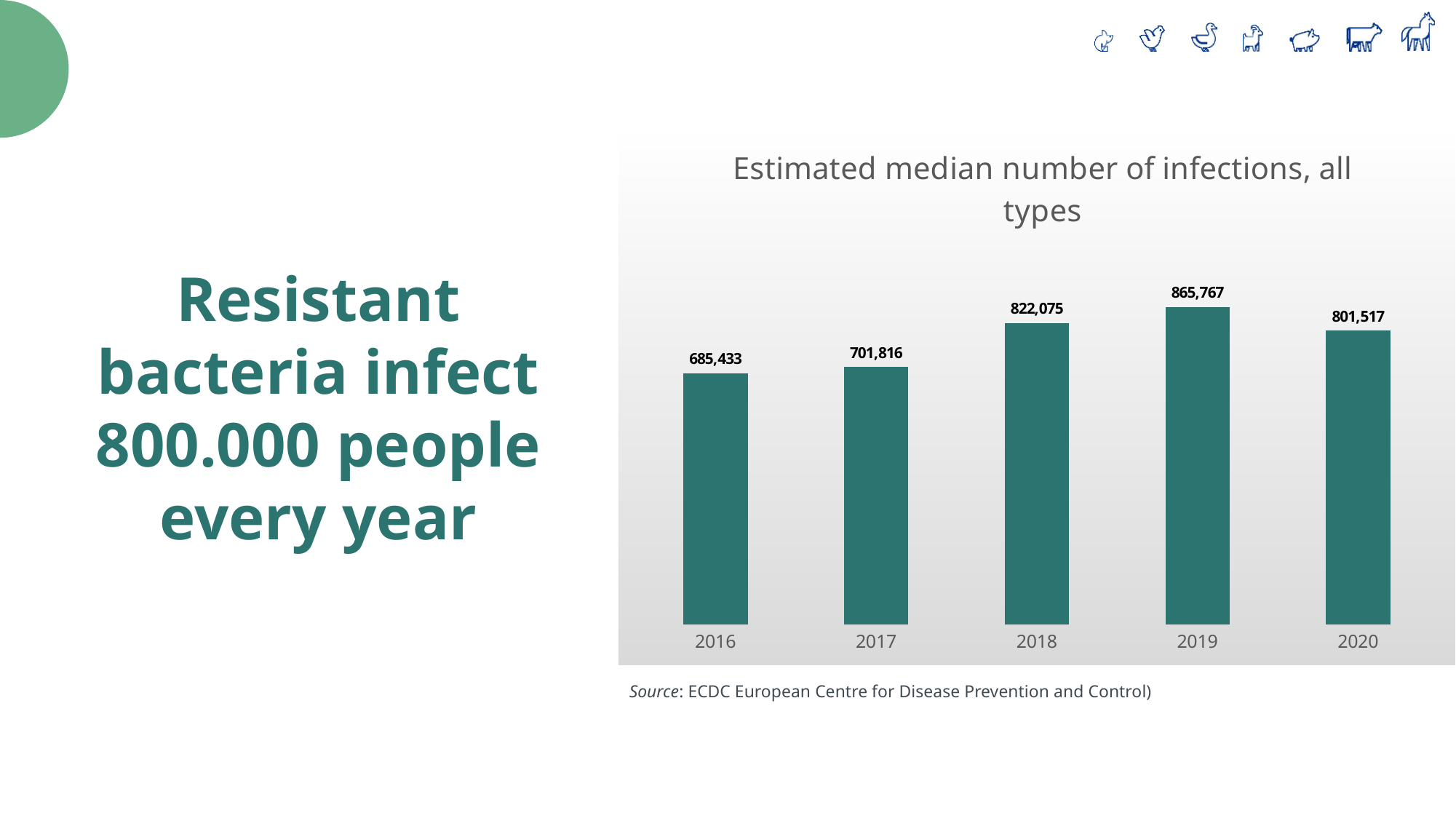
What kind of chart is shown on the slide? Bar chart Do the values rise or fall from 2016 to 2019? Rise What is the estimated median number of infections in 2020? 801,517 Which year has the lowest estimated median number of infections? 2016 What is the difference between the values for 2019 and 2020? 64,250 Which year has a larger value, 2018 or 2020? 2018 What is the estimated median number of infections in 2018? 822,075 Which year has the highest estimated median number of infections? 2019 How many years are shown on the chart? 5 What is the difference between the values for 2017 and 2016? 16,383 What is the title of the chart? Estimated median number of infections, all types What is the estimated median number of infections in 2016? 685,433